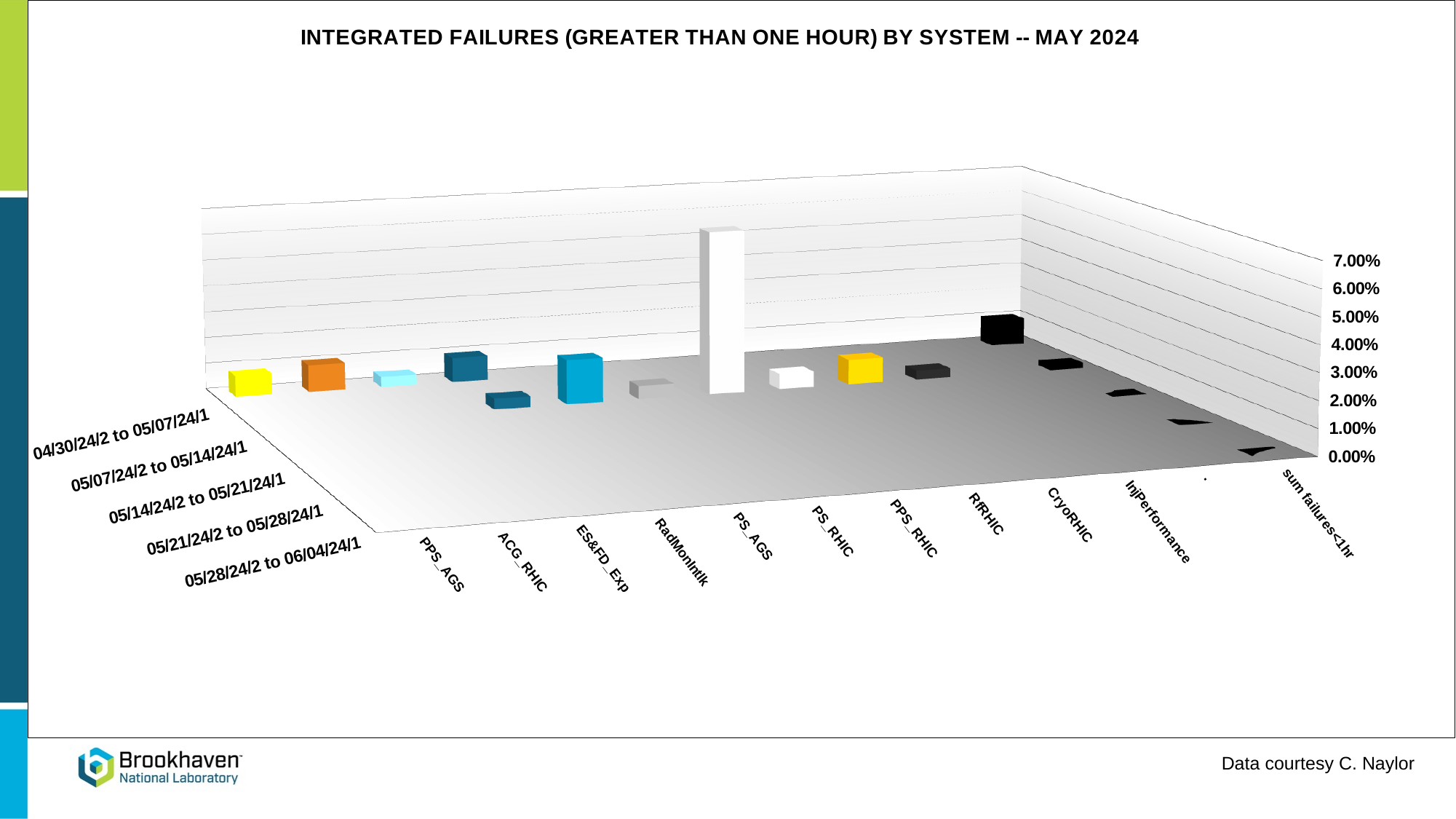
What is the first date range listed on the depth axis of the chart? 04/30/24/2 to 05/07/24/1 What kind of chart is shown on the slide? bar chart What is the title of the chart? INTEGRATED FAILURES (GREATER THAN ONE HOUR) BY SYSTEM -- MAY 2024 What is the first category label on the bottom axis of the chart? PPS_AGS How many weekly date ranges are listed along the depth axis of the chart? 5 What is the highest value shown on the vertical axis of the chart? 7.00% What is the last date range listed on the depth axis of the chart? 05/28/24/2 to 06/04/24/1 Which system has the tallest bar in the chart? PPS_RHIC What is the last category label on the bottom axis of the chart? sum failures<1hr How many system categories are labelled along the bottom axis of the chart? 12